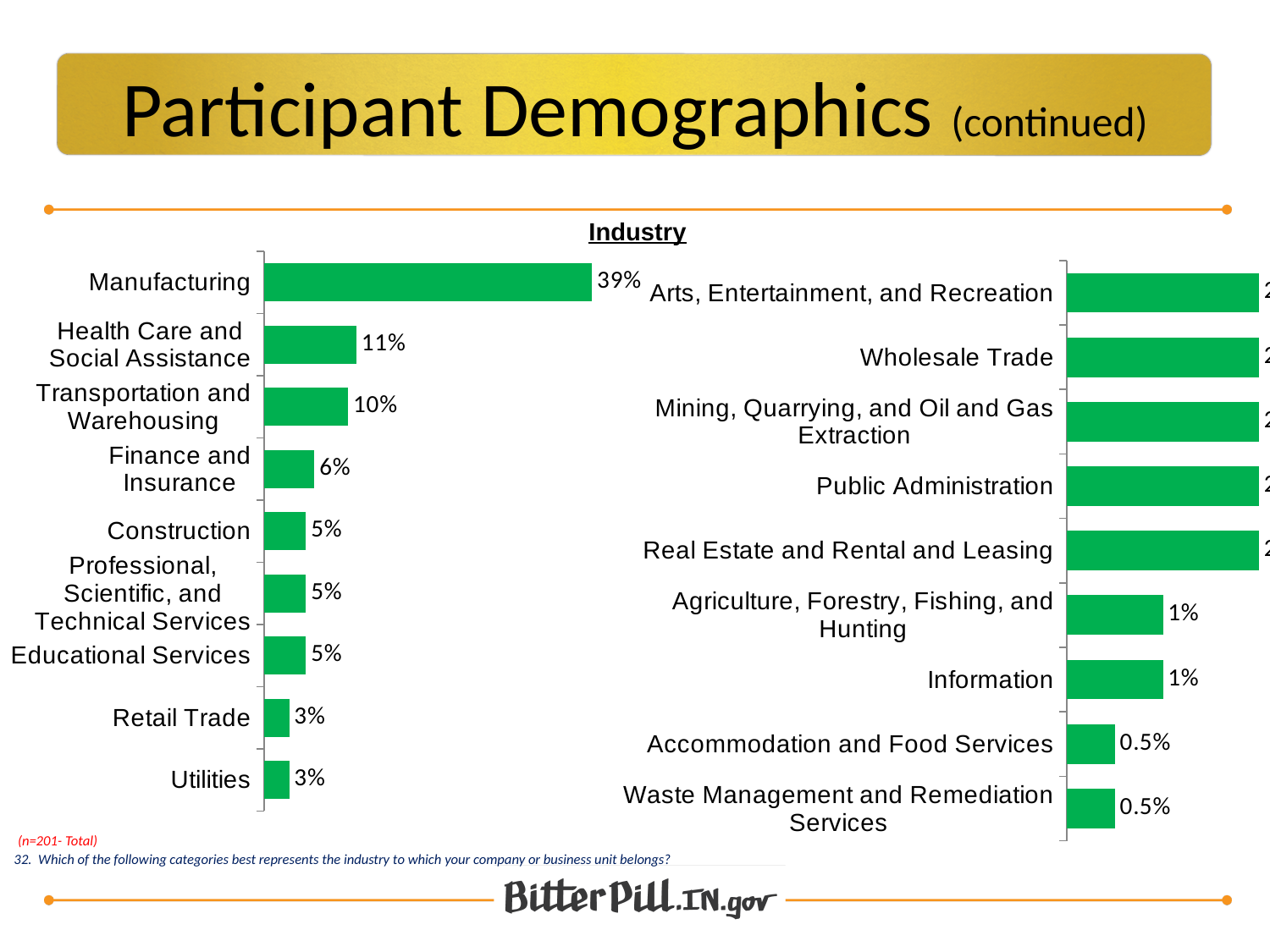
On the left chart, what is the value for Transportation and Warehousing? 10% What type of chart is used on the left side of the slide? Bar chart On the right chart, what is the value for Information? 1% On the left chart, which industry has the highest percentage? Manufacturing On the left chart, what is the difference between Manufacturing and Health Care and Social Assistance? 28% On the left chart, what is the value for Health Care and Social Assistance? 11% On the right chart, which is larger: Agriculture, Forestry, Fishing, and Hunting or Waste Management and Remediation Services? Agriculture, Forestry, Fishing, and Hunting On the left chart, how many industry categories are shown? 9 On the left chart, what percentage of participants are in Manufacturing? 39% On the left chart, which is larger: Finance and Insurance or Construction? Finance and Insurance On the right chart, how many industry categories are shown? 9 On the right chart, what is the value for Accommodation and Food Services? 0.5%